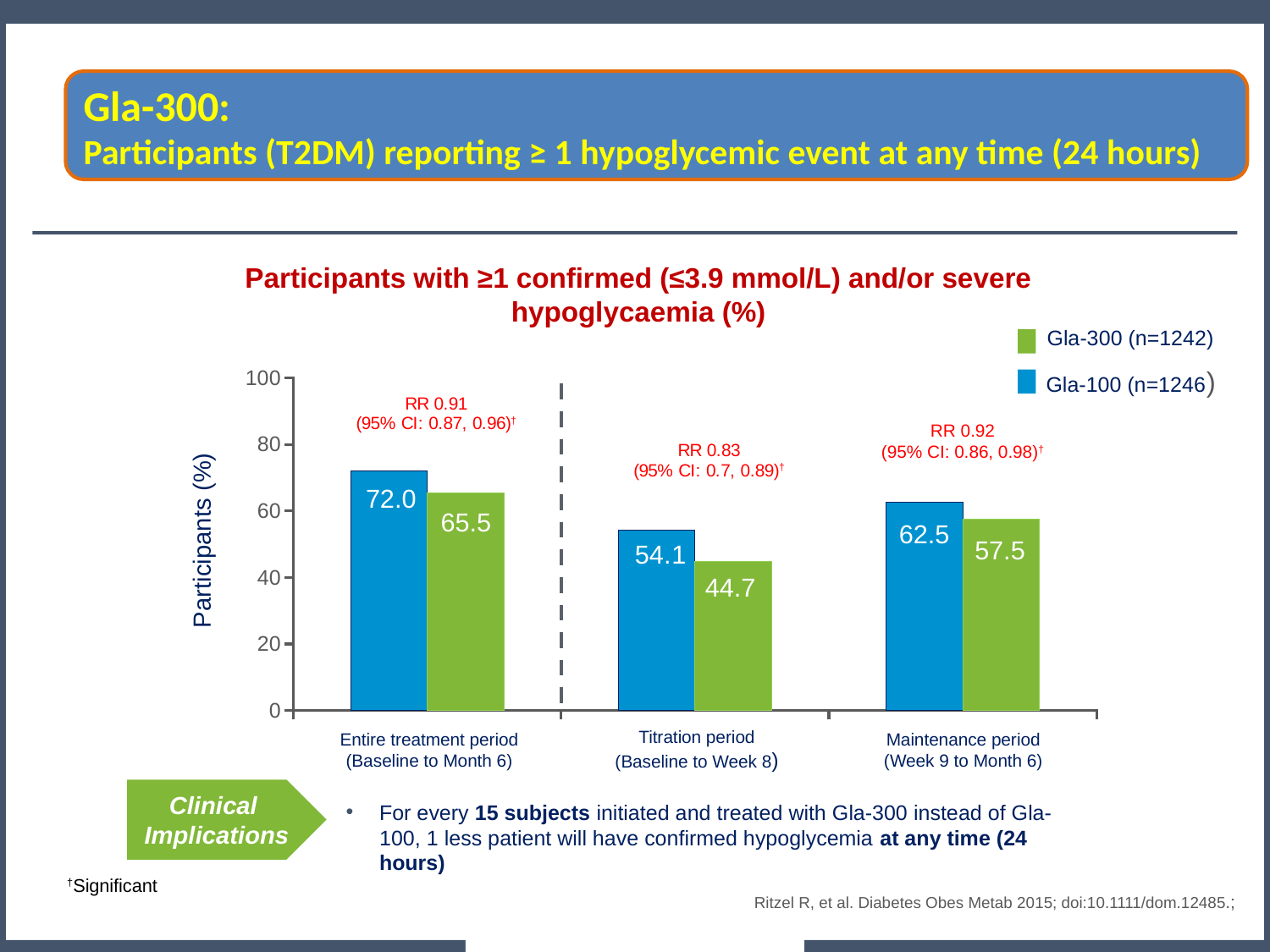
Which is larger in the Entire treatment period: the Gla-100 value or the Gla-300 value? Gla-100 In which period is the Gla-300 value lowest? Titration period (Baseline to Week 8) How many series does the legend list? 2 In which period is the Gla-100 value highest? Entire treatment period (Baseline to Month 6) What is the difference between the Gla-100 and Gla-300 values in the Titration period (Baseline to Week 8)? 9.4 How many periods (categories) are shown on the x axis? 3 What is the value for Gla-100 in the Maintenance period (Week 9 to Month 6)? 62.5 What is the value for Gla-100 in the Entire treatment period (Baseline to Month 6)? 72.0 What is the value for Gla-300 in the Maintenance period (Week 9 to Month 6)? 57.5 What is the RR shown for the Titration period (Baseline to Week 8)? RR 0.83 What is the value for Gla-300 in the Titration period (Baseline to Week 8)? 44.7 What kind of chart is shown on the slide? Bar chart